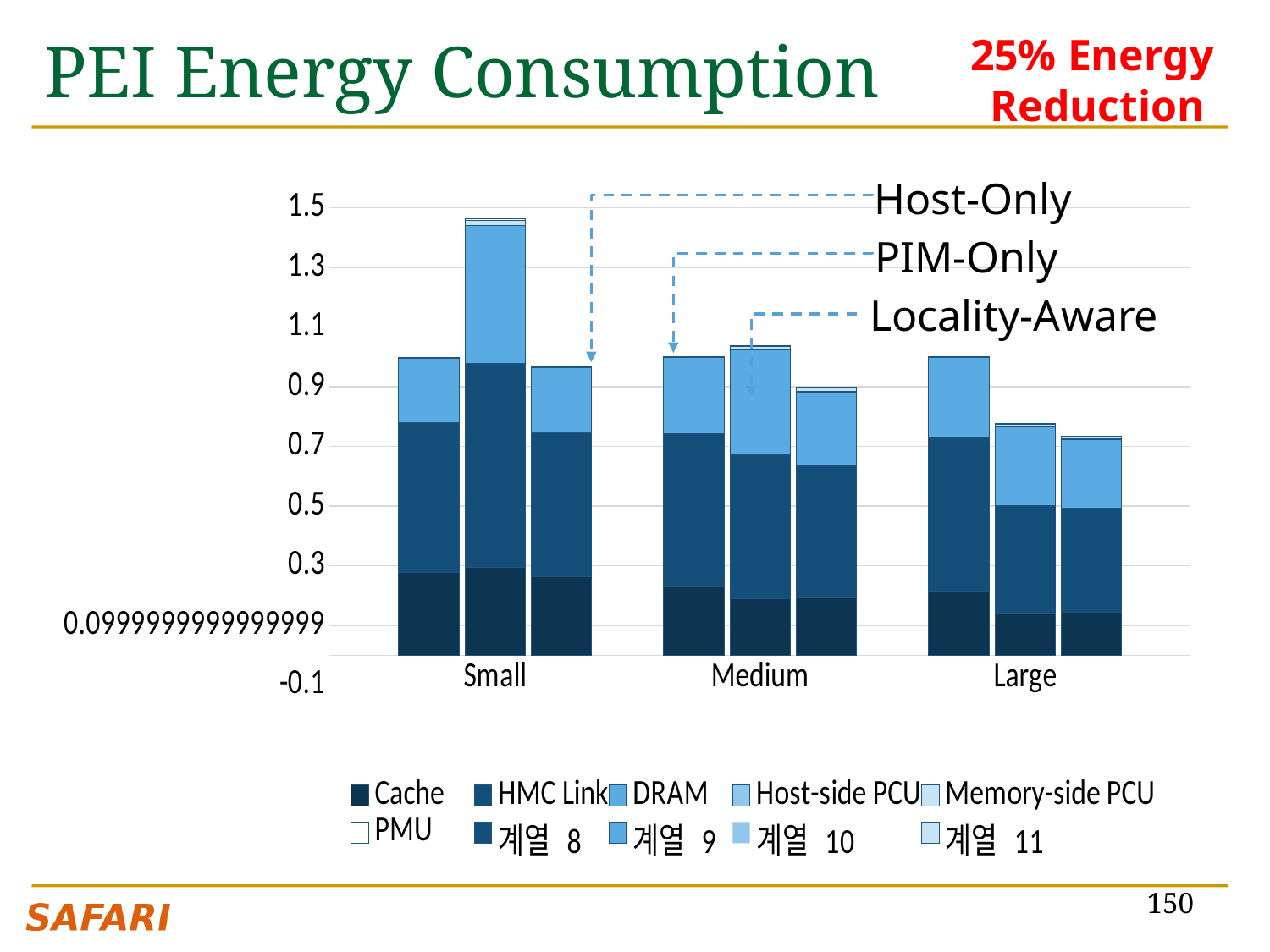
What kind of chart is shown on the slide? stacked bar chart Is the PIM-Only bar for Medium greater or less than 0.9? greater What is the first entry listed in the chart's legend? Cache In the Small group, which bar is taller: Host-Only or PIM-Only? PIM-Only What is the title of the chart on the slide? PEI Energy Consumption Is the PIM-Only bar for Small greater or less than 1.3? greater Is the Locality-Aware bar for Large greater or less than 0.9? less In the Large group, which bar is taller: Host-Only or Locality-Aware? Host-Only Which category group contains the tallest bar in the chart? Small Do the PIM-Only bars rise or fall going from Small to Medium to Large? fall How many series does the chart's legend list? 10 How many categories are shown on the x axis of the chart? 3